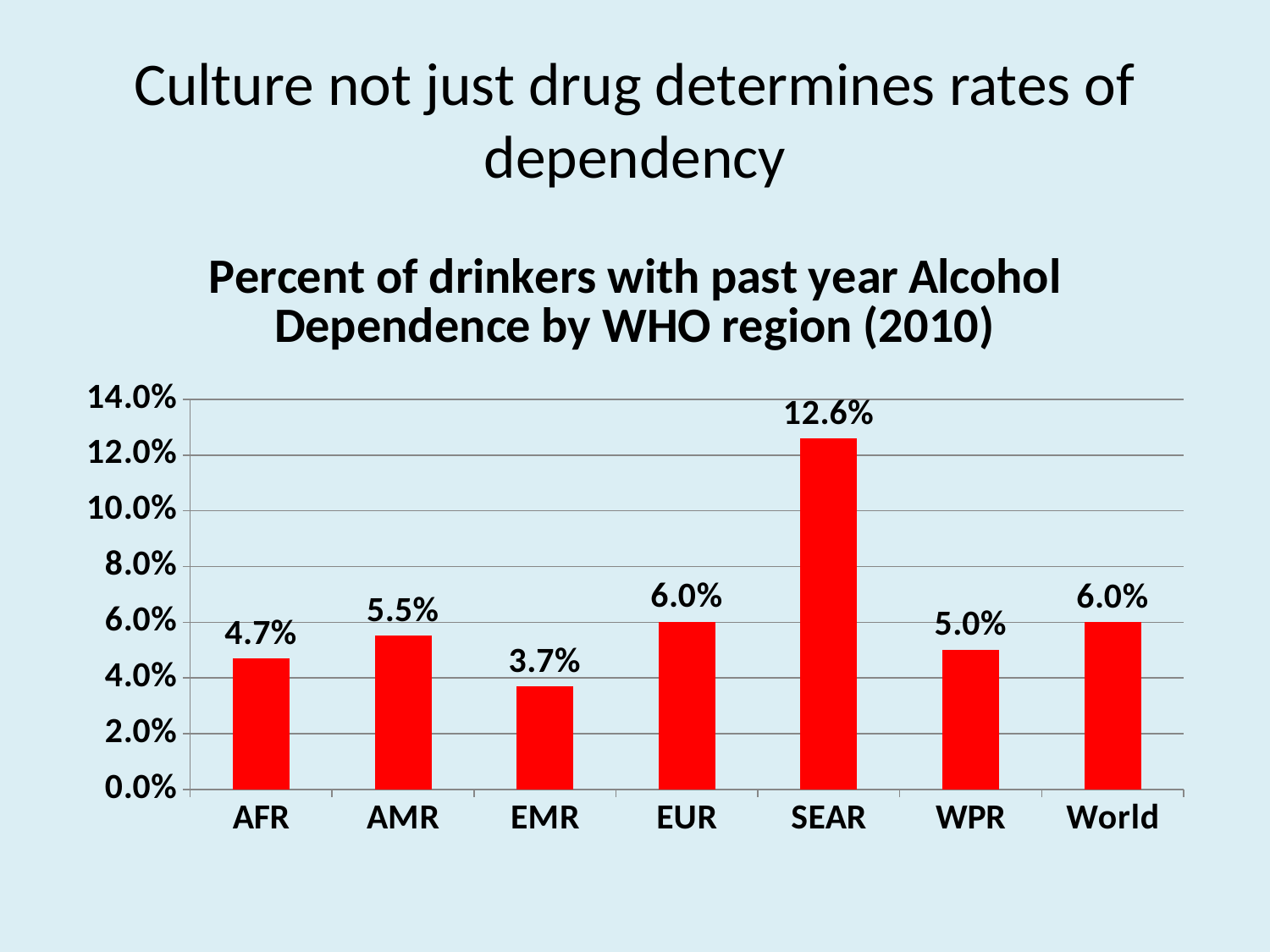
How many categories are shown on the x axis? 7 Which region has the lowest percent of drinkers with past year alcohol dependence? EMR What is the value for AFR? 4.7% Is the value for SEAR greater or less than 10.0%? greater What is the value for SEAR? 12.6% What is the difference between the values for SEAR and EMR? 8.9% Which region has the highest percent of drinkers with past year alcohol dependence? SEAR What is the value for WPR? 5.0% Which is larger, the value for AMR or the value for WPR? AMR What kind of chart is shown on the slide? bar chart What is the title of the chart? Percent of drinkers with past year Alcohol Dependence by WHO region (2010) What is the difference between the values for AMR and AFR? 0.8%